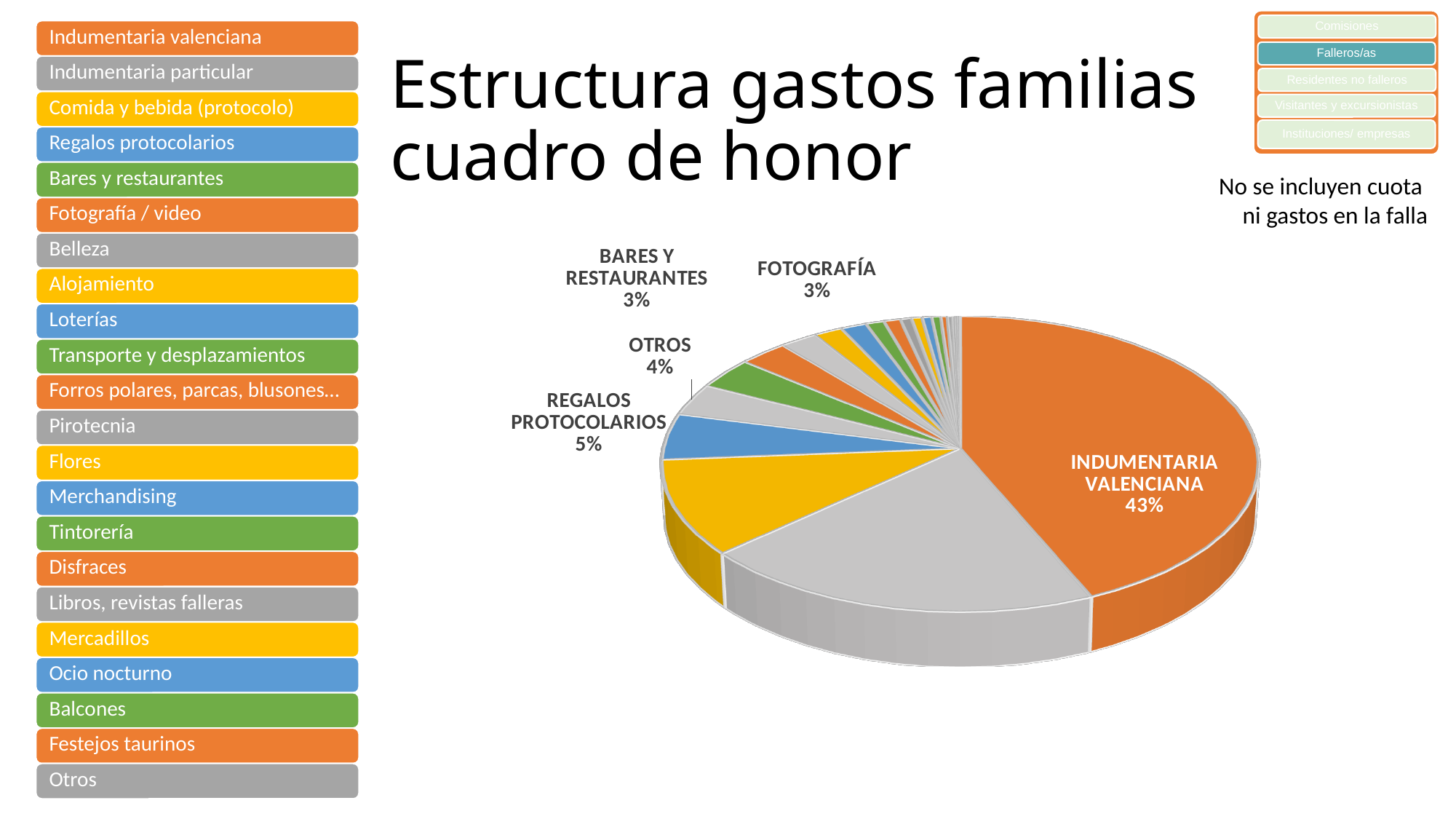
What is the value shown for Regalos Protocolarios? 5% Which is larger, Regalos Protocolarios or Otros? Regalos Protocolarios What colour is the Indumentaria Valenciana slice of the pie? orange What is the value shown for Fotografía? 3% What is the difference in percentage points between Regalos Protocolarios and Fotografía? 2 What is the title of the slide containing the pie chart? Estructura gastos familias cuadro de honor Which category has the largest slice of the pie? Indumentaria Valenciana What share of the pie does Indumentaria Valenciana represent? 43% What kind of chart is shown on the slide? pie chart What is the value shown for Otros? 4% What is the value shown for Bares y Restaurantes? 3% What is the difference in percentage points between Indumentaria Valenciana and Regalos Protocolarios? 38